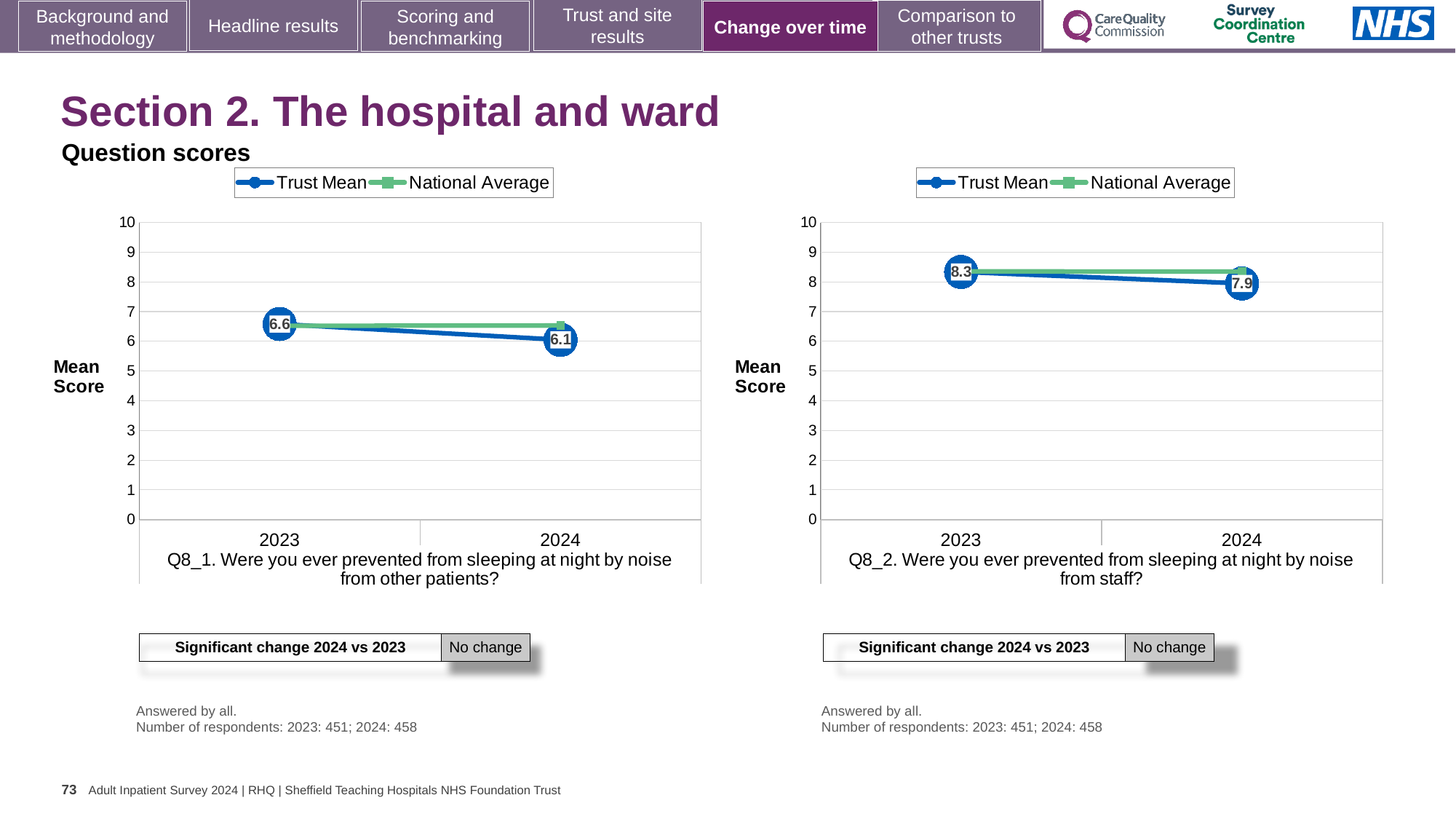
What kind of chart is the Q8_2 chart (right)? line chart On the Q8_1 chart (left), what is the Trust Mean score for 2023? 6.6 On the Q8_2 chart (right), does the Trust Mean rise or fall from 2023 to 2024? fall On the Q8_2 chart (right), which year has the higher Trust Mean, 2023 or 2024? 2023 On the Q8_2 chart (right), what is the difference between the Trust Mean in 2023 and 2024? 0.4 On the Q8_2 chart (right), what is the Trust Mean score for 2024? 7.9 On the Q8_2 chart (right), what is the Trust Mean score for 2023? 8.3 On the Q8_1 chart (left), is the National Average for 2024 greater or less than 5? greater On the Q8_1 chart (left), does the Trust Mean rise or fall from 2023 to 2024? fall How many series does the legend of the Q8_1 chart (left) list? 2 On the Q8_1 chart (left), what is the Trust Mean score for 2024? 6.1 On the Q8_1 chart (left), by how much did the Trust Mean change from 2023 to 2024? 0.5